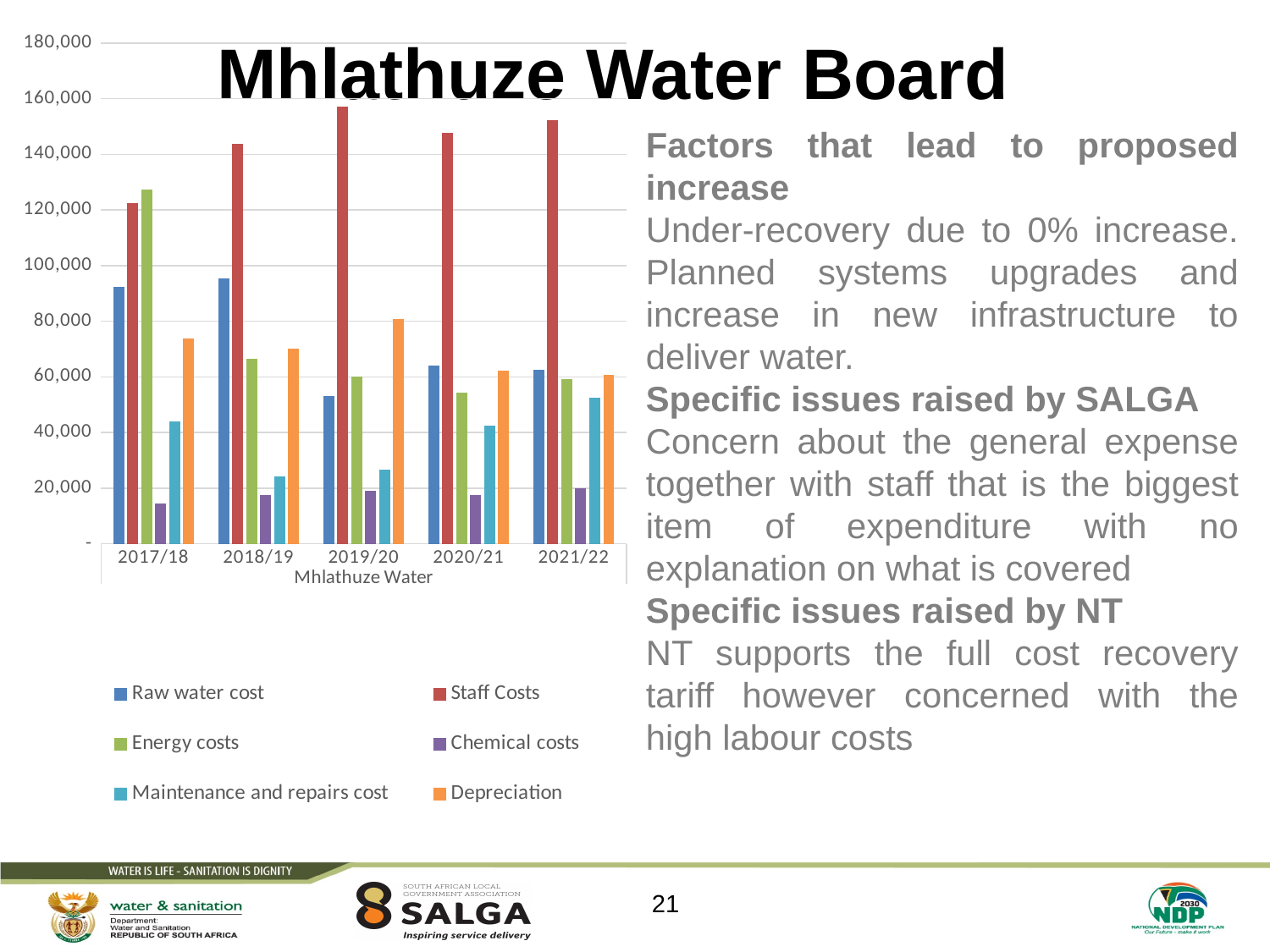
How many financial years are shown on the x axis of the chart? 5 Which series has the lowest value in 2020/21? Chemical costs How many series does the chart's legend list? 6 Is the value for Raw water cost in 2017/18 greater or less than 80,000? greater Is the value for Staff Costs in 2019/20 greater or less than 140,000? greater Is the value for Chemical costs in 2017/18 greater or less than 20,000? less Which is larger: Raw water cost in 2018/19 or Raw water cost in 2019/20? 2018/19 What colour represents Staff Costs in the chart's legend? red Which series has the highest value in 2018/19? Staff Costs What kind of chart is shown on the slide? bar chart